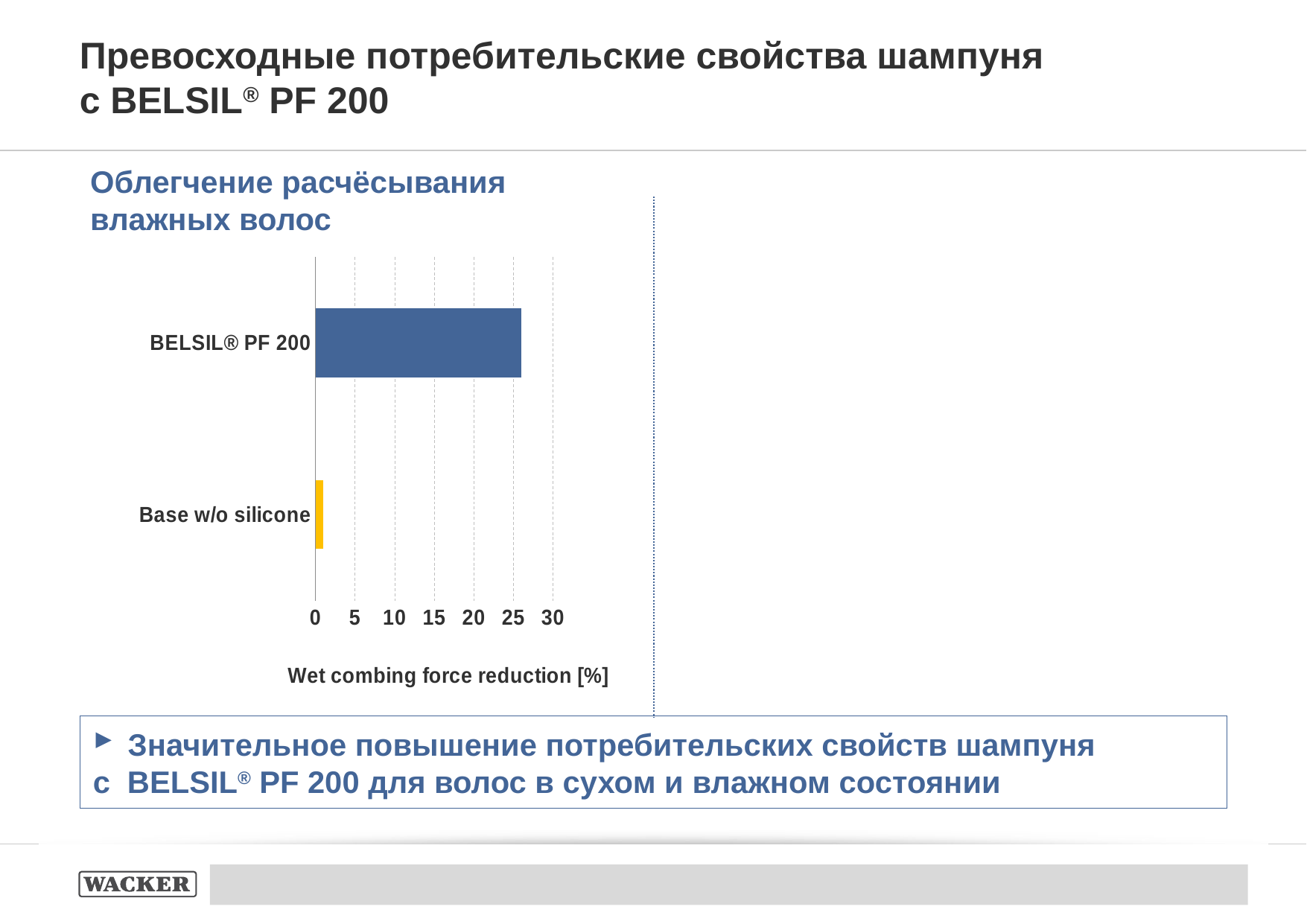
What is the title of the horizontal axis of the chart? Wet combing force reduction [%] What kind of chart is shown on the slide? bar chart Which category has the lowest wet combing force reduction? Base w/o silicone Is the value for BELSIL® PF 200 greater or less than 30? less What is the heading shown above the chart? Облегчение расчёсывания влажных волос How many categories are plotted in the chart? 2 Which category has the highest wet combing force reduction? BELSIL® PF 200 Is the value for Base w/o silicone greater or less than 5? less Is the value for BELSIL® PF 200 greater or less than 20? greater Which is larger, the value for BELSIL® PF 200 or the value for Base w/o silicone? BELSIL® PF 200